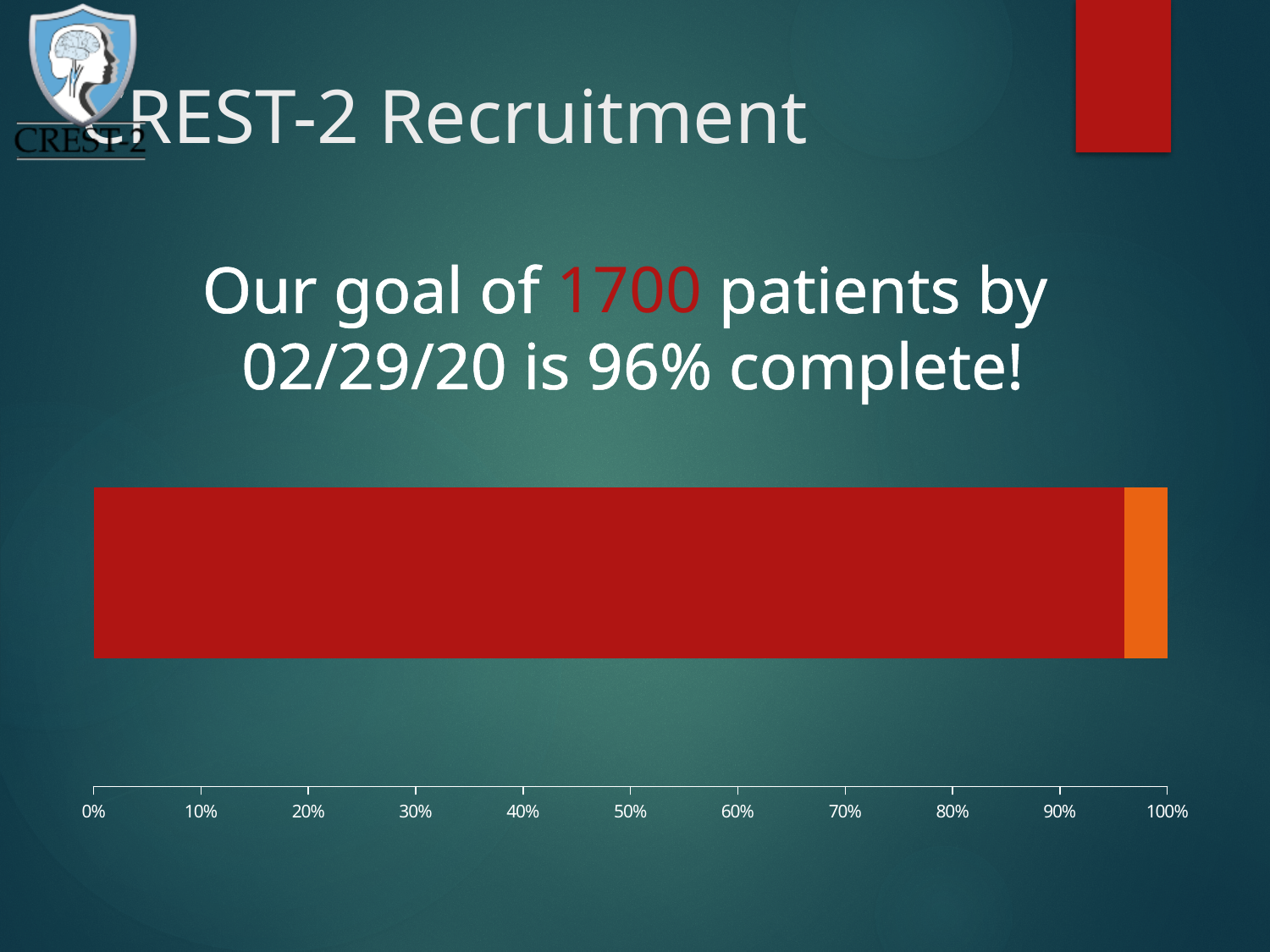
Is the orange portion of the bar greater or less than 10% of the axis? less What percentage of the goal remains, based on the 96% complete figure and the 100% axis maximum? 4% Which segment of the bar is larger, the red one or the orange one? the red one What is the recruitment goal in patients stated on the slide? 1700 How many bars are plotted in the chart? 1 What kind of chart is shown on the slide? bar chart Is the red portion of the bar greater or less than 100%? less How many tick labels are shown on the percentage axis? 11 What is the maximum value labelled on the horizontal axis? 100% Is the red portion of the bar greater or less than 90%? greater According to the slide, what percentage of the recruitment goal is complete? 96%